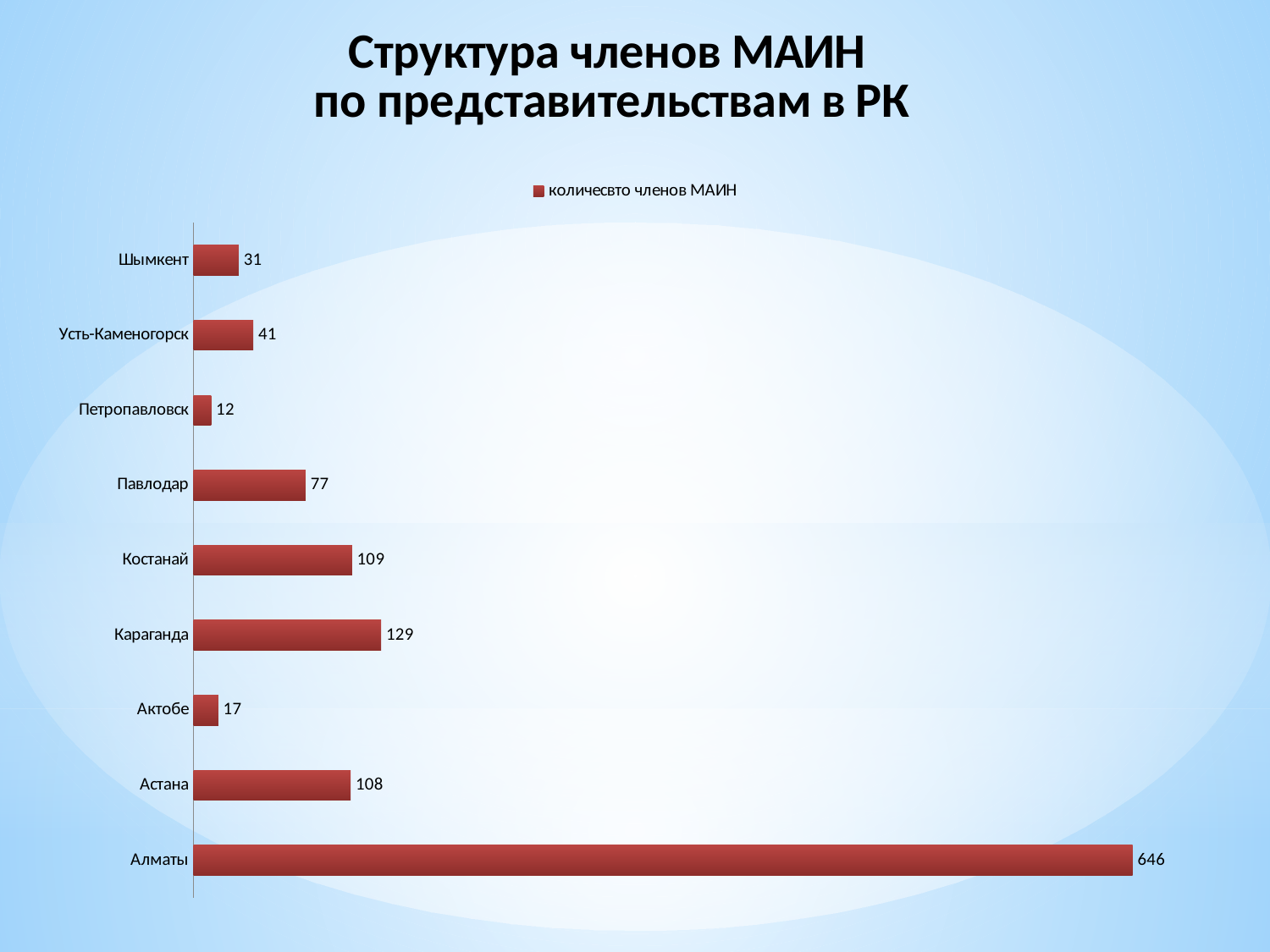
Which is larger, the value for Павлодар or the value for Актобе? Павлодар What is the value for Алматы? 646 Which city has the highest number of members? Алматы What is the difference between the values for Алматы and Астана? 538 What is the value for Петропавловск? 12 What kind of chart is shown on the slide? bar chart How many series does the legend list? 1 Which city has the lowest number of members? Петропавловск What is the difference between the values for Усть-Каменогорск and Шымкент? 10 What is the legend entry of the chart? количесвто членов МАИН What is the value for Караганда? 129 How many cities are shown on the chart? 9